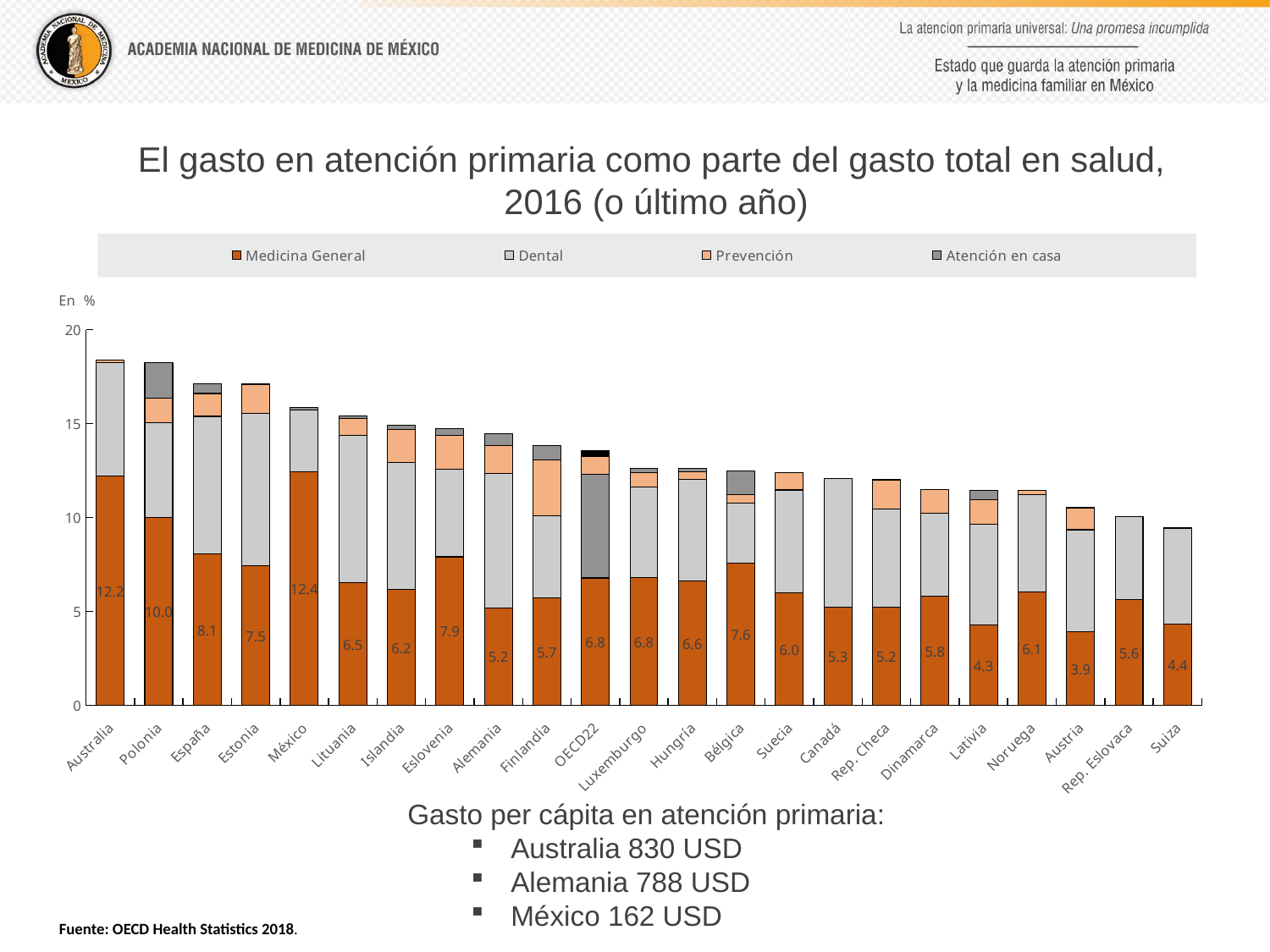
What kind of chart is shown on the slide? Stacked bar chart How many countries or groups are shown on the x axis? 23 What is the difference between the Medicina General values for Polonia and España? 1.9 Which country has the lowest Medicina General value? Austria Which country has the highest Medicina General value? México What is the Medicina General value for Australia? 12.2 Which has a larger Medicina General value, Polonia or Suecia? Polonia What is the Medicina General value for México? 12.4 How many series does the legend list? 4 What is the Medicina General value for Alemania? 5.2 Is the total bar height for Suiza greater or less than 10? less Is the total bar height for Australia greater or less than 15? greater